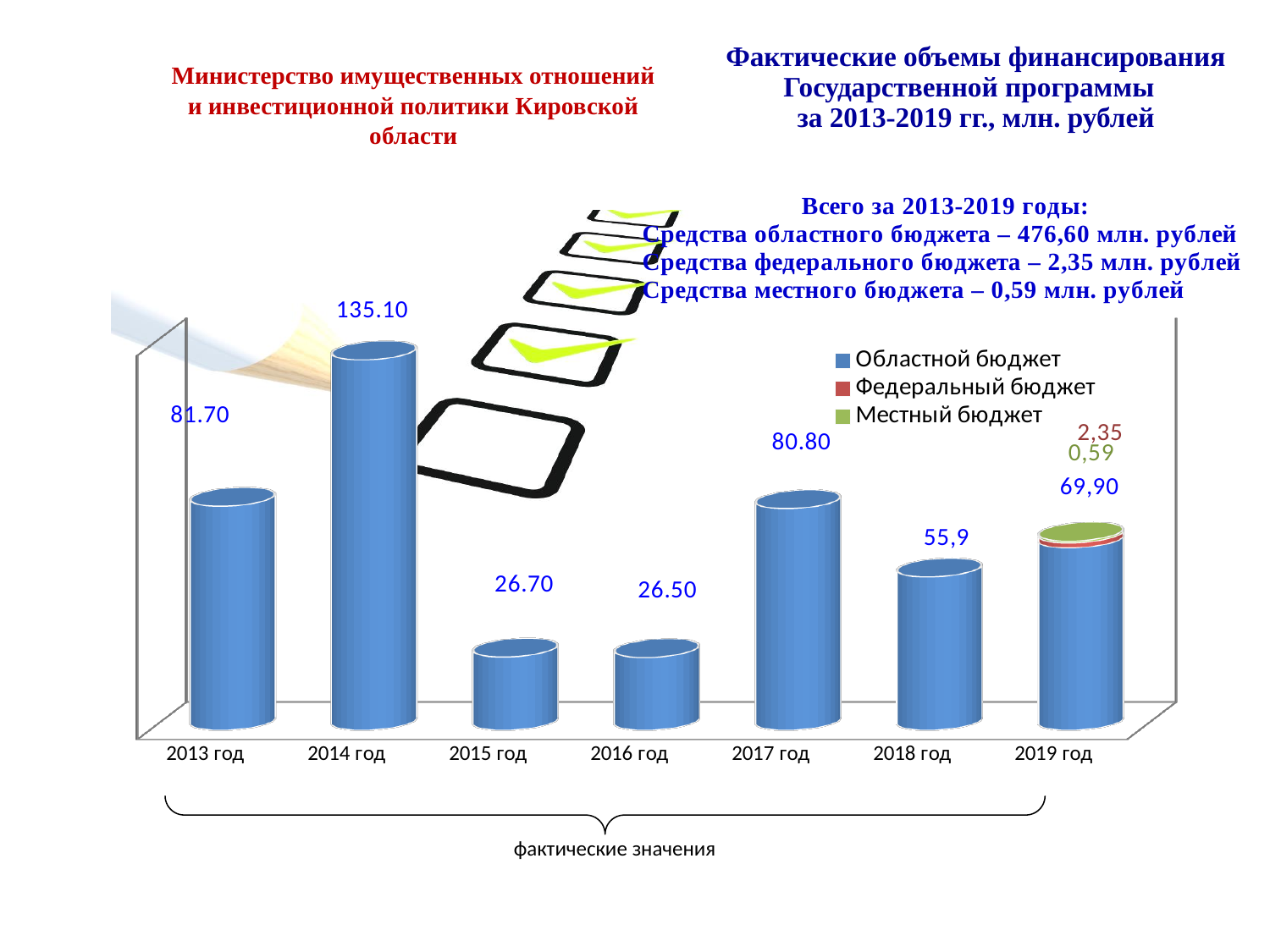
How many series does the legend list? 3 Which year has the larger Областной бюджет value, 2017 год or 2018 год? 2017 год Which year has the highest value for Областной бюджет? 2014 год What is the difference between the Областной бюджет values for 2014 год and 2013 год? 53.40 Which year has the lowest value for Областной бюджет? 2016 год What is the total of the stacked bar for 2019 год? 72,84 What is the value for Местный бюджет in 2019 год? 0,59 What is the value for Областной бюджет in 2018 год? 55,9 What kind of chart is shown on the slide? bar chart What is the value for Федеральный бюджет in 2019 год? 2,35 How many years are shown on the x axis? 7 What is the value for Областной бюджет in 2014 год? 135.10